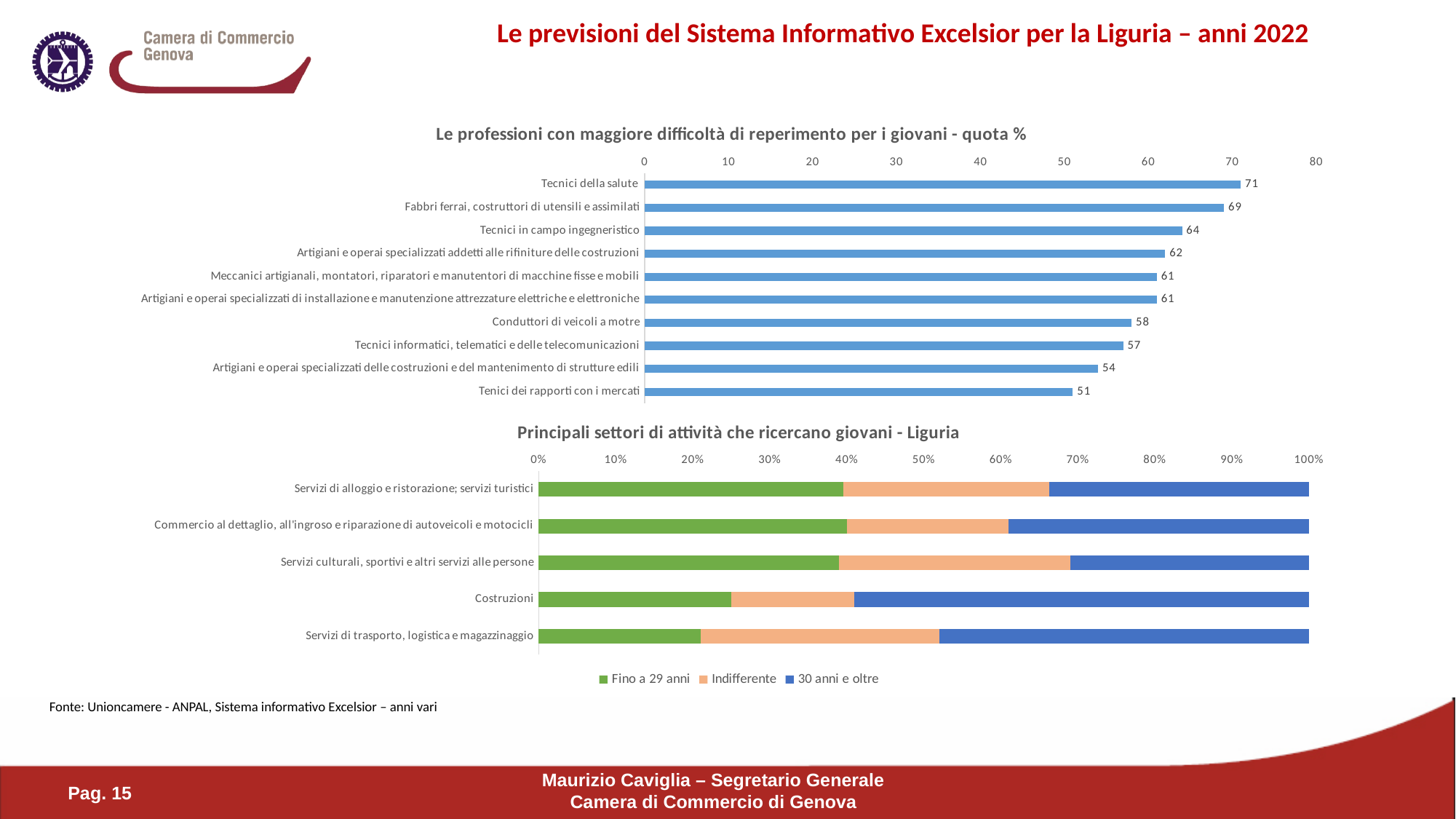
In the chart 'Le professioni con maggiore difficoltà di reperimento per i giovani - quota %', what is the value for Conduttori di veicoli a motre? 58 In the chart 'Le professioni con maggiore difficoltà di reperimento per i giovani - quota %', what is the difference between Tecnici della salute and Tenici dei rapporti con i mercati? 20 In the chart 'Le professioni con maggiore difficoltà di reperimento per i giovani - quota %', which is larger: Tecnici in campo ingegneristico or Tecnici informatici, telematici e delle telecomunicazioni? Tecnici in campo ingegneristico In the chart 'Le professioni con maggiore difficoltà di reperimento per i giovani - quota %', which profession has the highest value? Tecnici della salute In the chart 'Principali settori di attività che ricercano giovani - Liguria', is the 'Fino a 29 anni' share for Servizi di alloggio e ristorazione; servizi turistici greater or less than 30%? greater In the chart 'Principali settori di attività che ricercano giovani - Liguria', is the 'Fino a 29 anni' share for Costruzioni greater or less than 30%? less In the chart 'Principali settori di attività che ricercano giovani - Liguria', which colour represents the series '30 anni e oltre'? Blue How many series does the legend of the chart 'Principali settori di attività che ricercano giovani - Liguria' list? 3 What kind of chart is 'Le professioni con maggiore difficoltà di reperimento per i giovani - quota %'? Bar chart In the chart 'Le professioni con maggiore difficoltà di reperimento per i giovani - quota %', which profession has the lowest value? Tenici dei rapporti con i mercati How many professions are listed in the chart 'Le professioni con maggiore difficoltà di reperimento per i giovani - quota %'? 10 In the chart 'Le professioni con maggiore difficoltà di reperimento per i giovani - quota %', what is the value for Tecnici della salute? 71